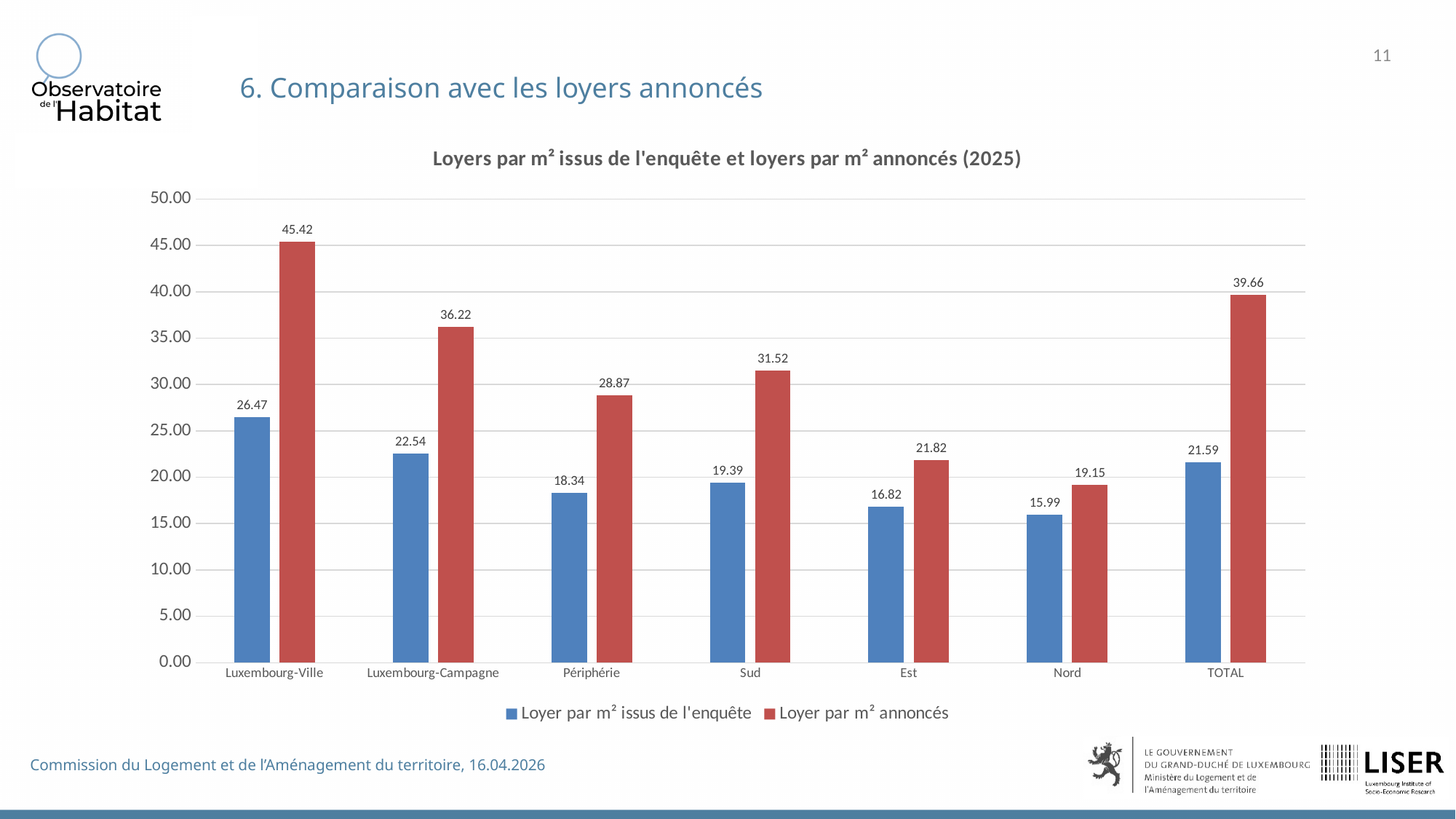
Which is larger for Est: 'Loyer par m² issus de l'enquête' or 'Loyer par m² annoncés'? Loyer par m² annoncés How many categories are shown on the x axis? 7 Which category has the lowest value for 'Loyer par m² issus de l'enquête'? Nord What kind of chart is shown on the slide? Bar chart What is the value of 'Loyer par m² annoncés' for TOTAL? 39.66 Is the value of 'Loyer par m² annoncés' for Périphérie greater or less than 30.00? less What is the title of the chart? Loyers par m² issus de l'enquête et loyers par m² annoncés (2025) How many series does the legend list? 2 What is the value of 'Loyer par m² annoncés' for Sud? 31.52 What is the value of 'Loyer par m² issus de l'enquête' for Luxembourg-Ville? 26.47 Which category has the highest value for 'Loyer par m² annoncés'? Luxembourg-Ville What is the difference between 'Loyer par m² annoncés' and 'Loyer par m² issus de l'enquête' for Luxembourg-Ville? 18.95